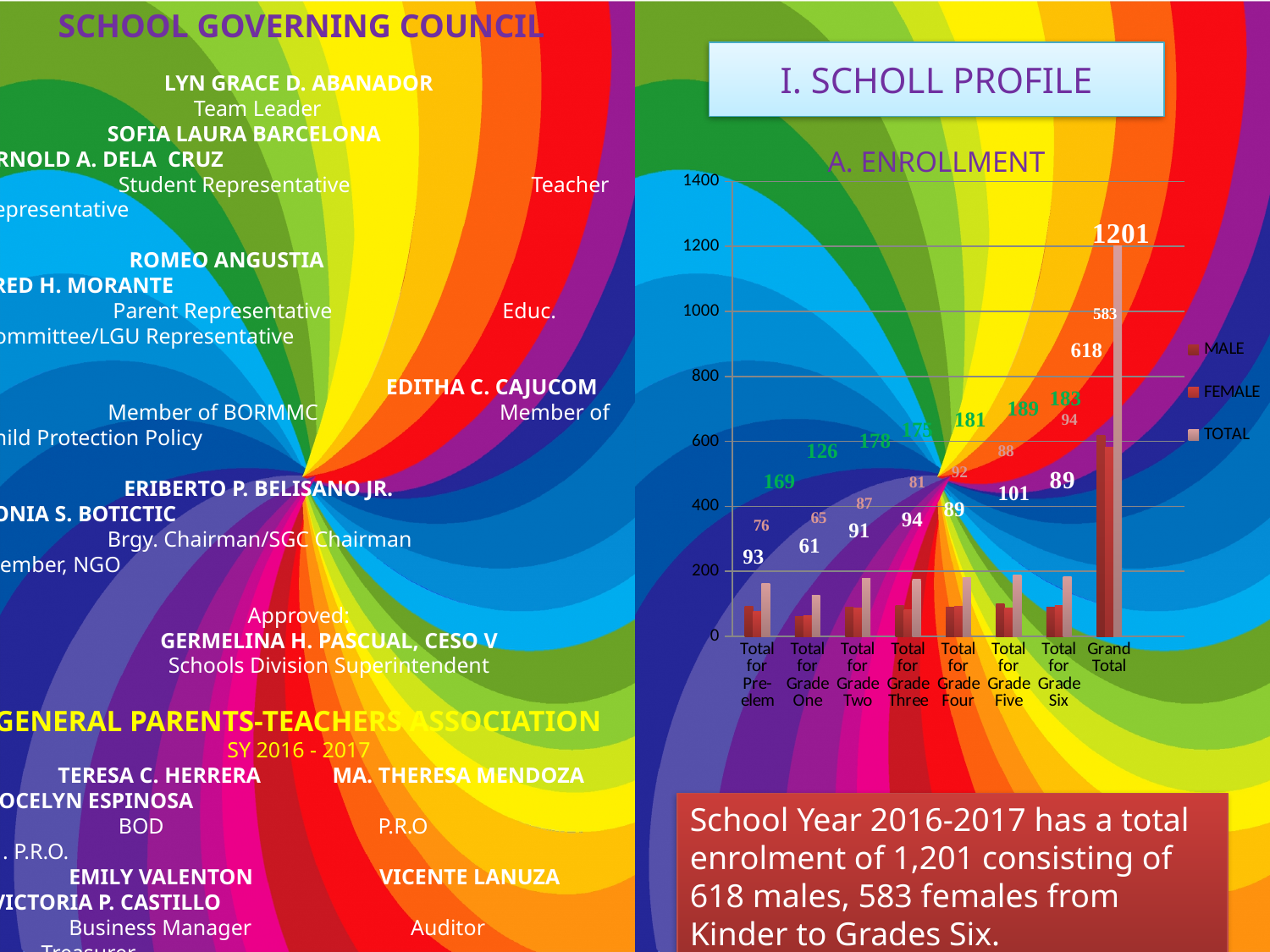
What is the TOTAL value for Total for Grade Five? 189 Excluding Grand Total, which category has the highest MALE value? Total for Grade Five What is the difference between the MALE and FEMALE values for Grand Total? 35 What kind of chart is shown? Bar chart What is the TOTAL value for Grand Total? 1201 How many categories are shown on the x axis? 8 Excluding Grand Total, which category has the lowest TOTAL value? Total for Grade One Which is larger for Total for Grade Six, the MALE value or the FEMALE value? FEMALE What is the title of the chart? A. ENROLLMENT How many series does the legend list? 3 What is the FEMALE value for Total for Grade Four? 92 What is the MALE value for Total for Pre-elem? 93